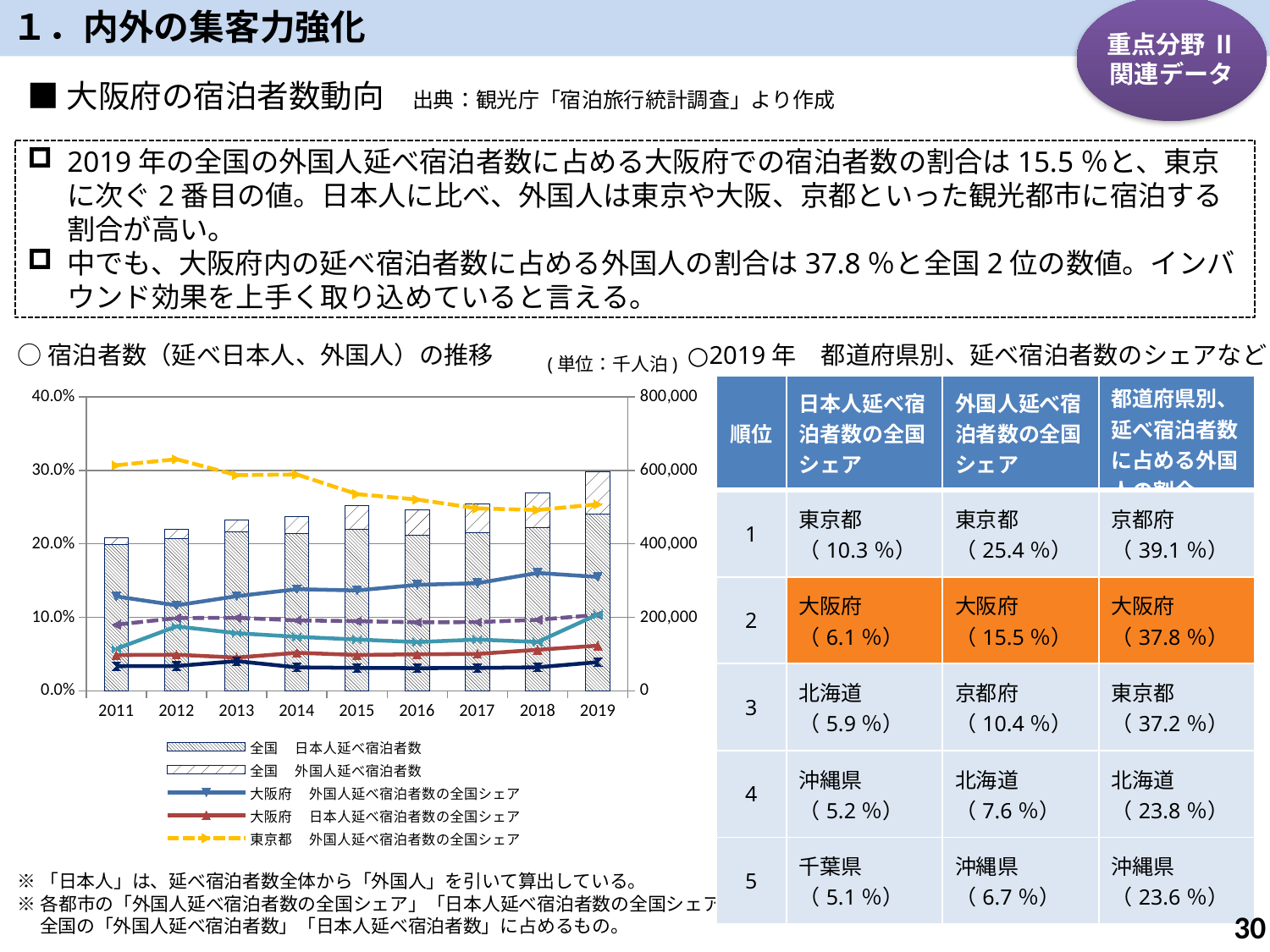
How many years are shown on the x axis of the chart? 9 What unit is stated for the chart's right-hand axis? 千人泊 In 2019, which is larger: the 東京都 外国人延べ宿泊者数の全国シェア or the 大阪府 外国人延べ宿泊者数の全国シェア? 東京都 外国人延べ宿泊者数の全国シェア How many series does the chart's legend list? 5 Is the 東京都 外国人延べ宿泊者数の全国シェア value for 2019 greater or less than 30.0%? less Does the 大阪府 外国人延べ宿泊者数の全国シェア line rise or fall overall from 2011 to 2019? Rise What kind of chart is the chart titled 宿泊者数（延べ日本人、外国人）の推移? A combined bar and line chart What is the first year shown on the x axis of the chart? 2011 What is the last year shown on the x axis of the chart? 2019 Does the 東京都 外国人延べ宿泊者数の全国シェア line rise or fall from 2011 to 2019? Fall Is the 大阪府 外国人延べ宿泊者数の全国シェア value for 2019 greater or less than 10.0%? greater Is the total height of the stacked bar for 2011 greater or less than 600,000? less